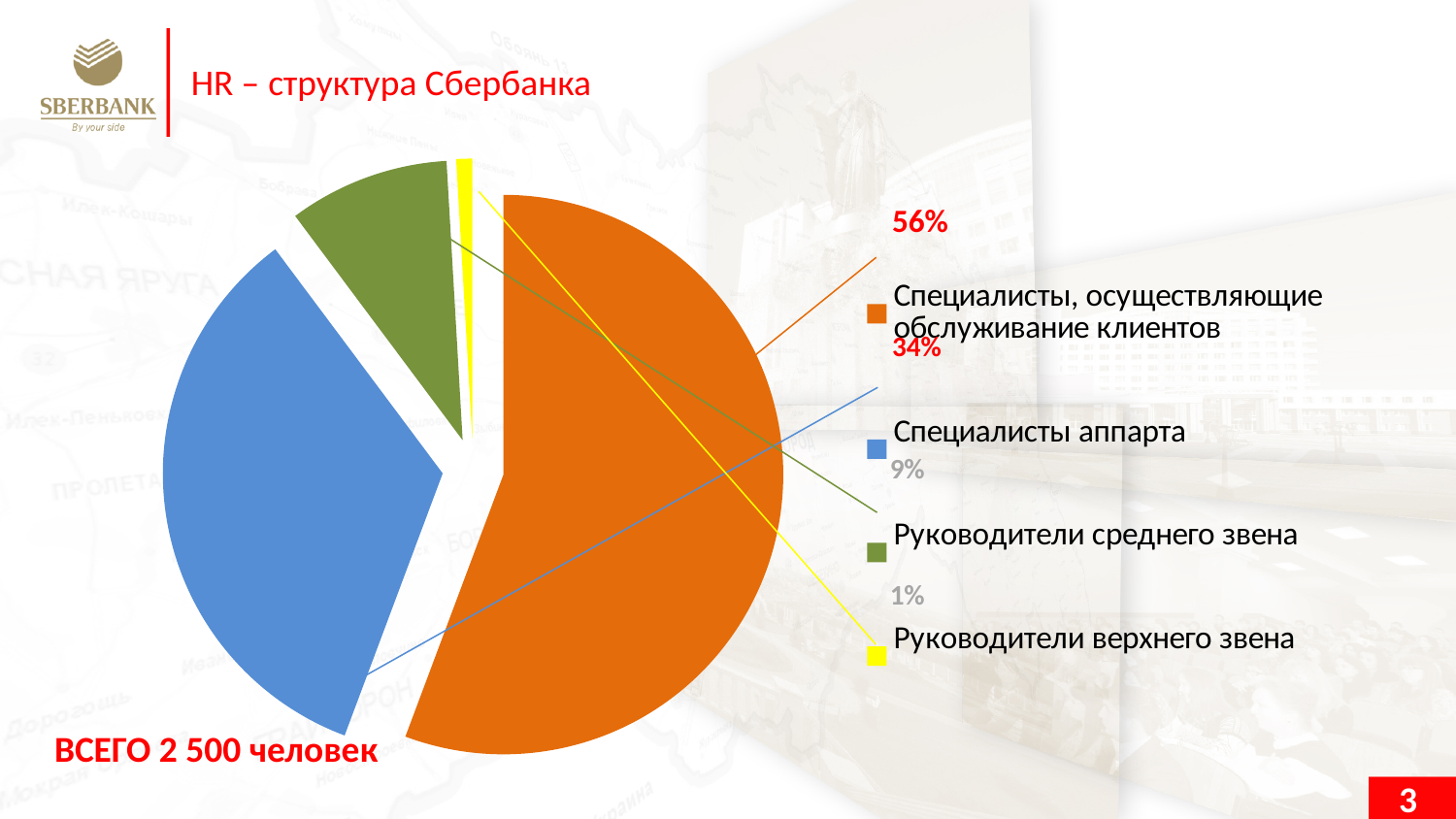
Which category has the smallest slice of the pie? Руководители верхнего звена What share of the pie is labelled for "Специалисты аппарта"? 34% What colour is the slice for "Специалисты аппарта"? Blue What is the difference in percentage points between "Специалисты, осуществляющие обслуживание клиентов" and "Специалисты аппарта"? 22 What total number of people does the slide state the chart covers? 2 500 человек Which is larger: the share for "Руководители среднего звена" or for "Руководители верхнего звена"? Руководители среднего звена How many categories does the pie chart have? 4 What share of the pie is labelled for "Руководители верхнего звена"? 1% What kind of chart is shown on the slide? Pie chart Which category has the largest slice of the pie? Специалисты, осуществляющие обслуживание клиентов What share of the pie is labelled for "Специалисты, осуществляющие обслуживание клиентов"? 56% What share of the pie is labelled for "Руководители среднего звена"? 9%